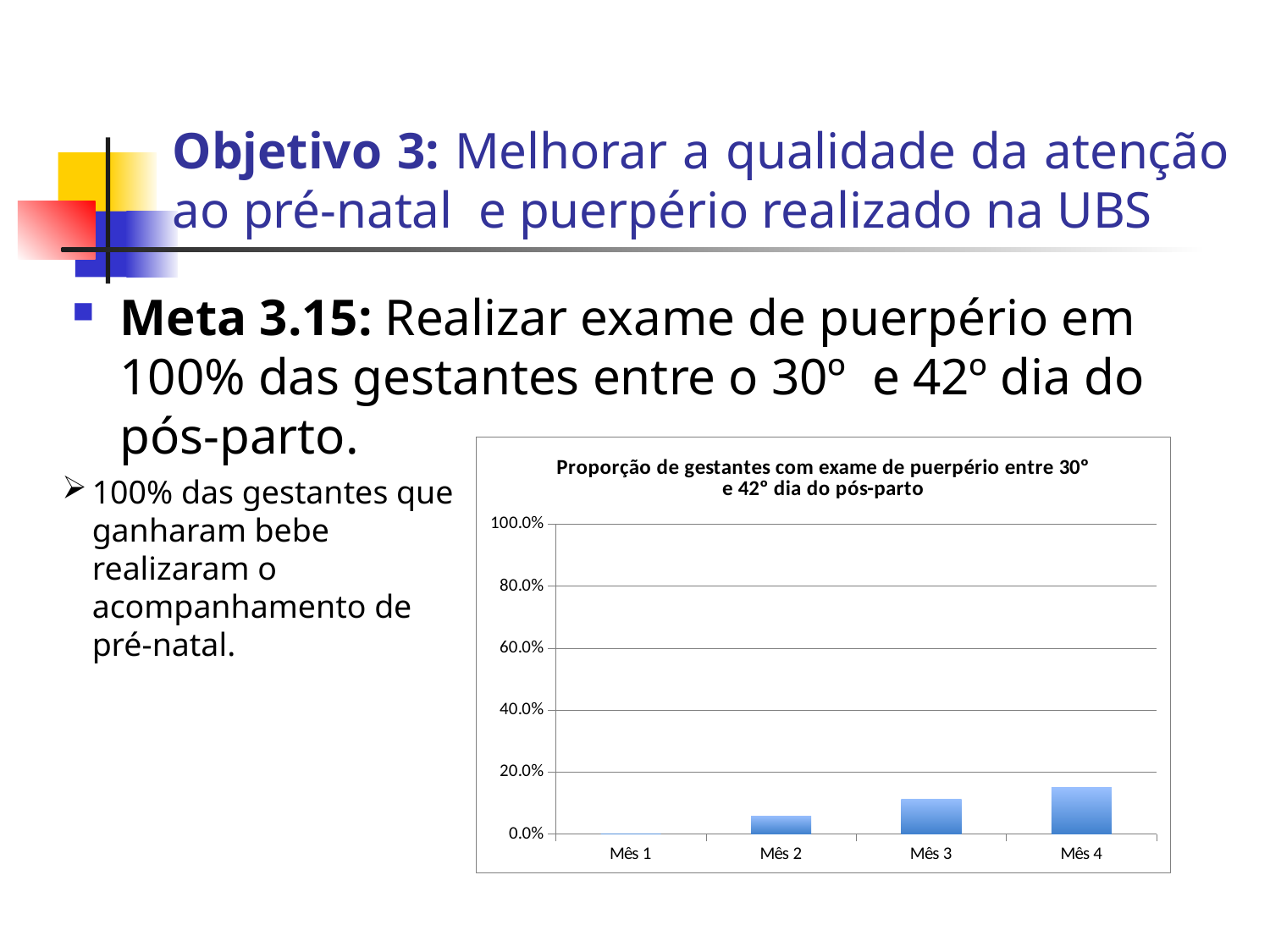
What is the highest value labelled on the y axis of the chart? 100.0% Which is larger, the value for Mês 2 or the value for Mês 4? Mês 4 Which is larger, the value for Mês 2 or the value for Mês 3? Mês 3 Is the value for Mês 3 greater or less than 20.0%? less What is the value shown for Mês 1 in the chart? 0.0% Do the values rise or fall from Mês 1 to Mês 4? rise How many categories (months) are shown on the x axis of the chart? 4 Is the value for Mês 4 greater or less than 20.0%? less What is the title of the chart? Proporção de gestantes com exame de puerpério entre 30° e 42° dia do pós-parto Which month has the highest value in the chart? Mês 4 What kind of chart is shown on the slide? bar chart Which month has the lowest value in the chart? Mês 1